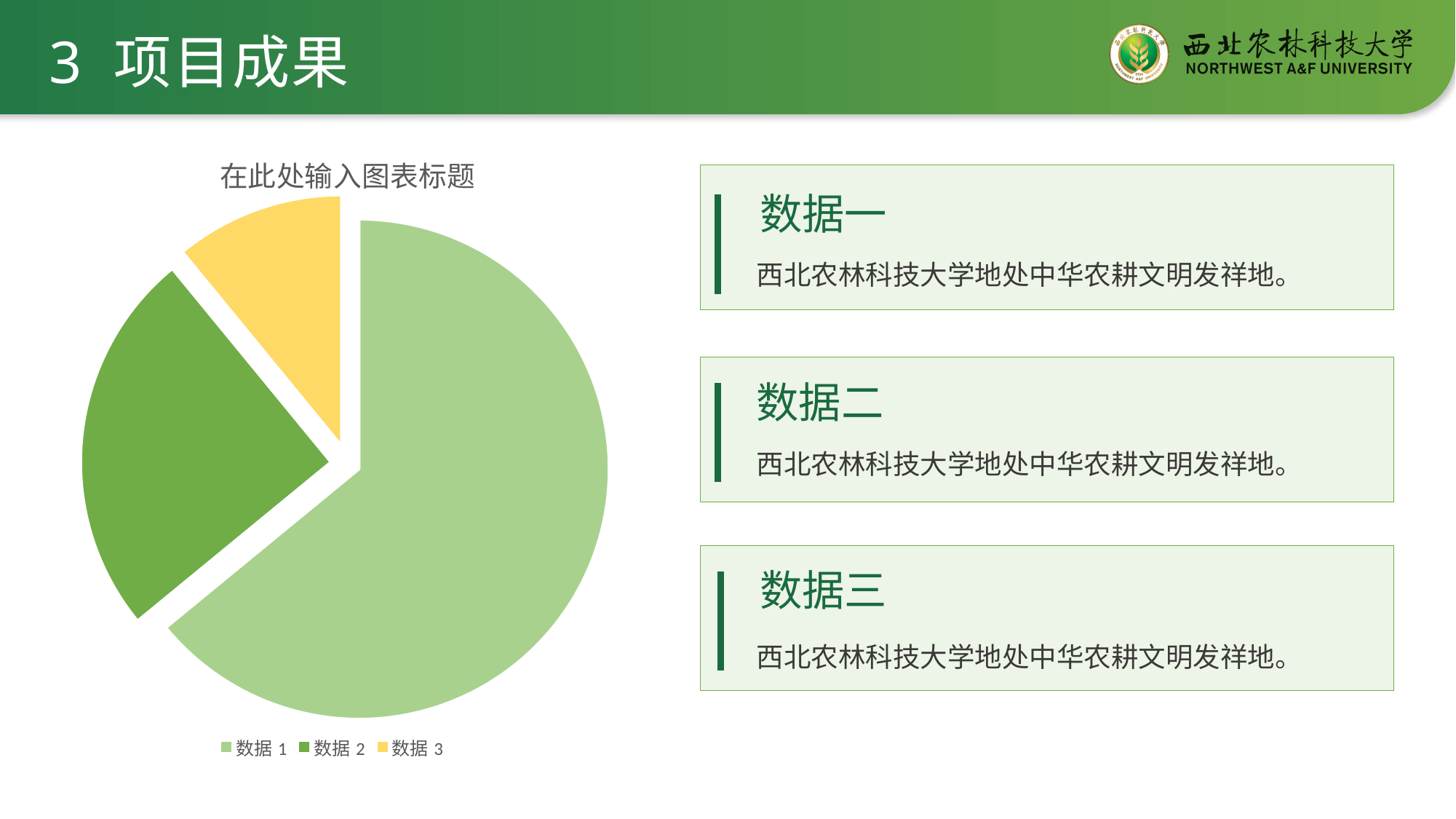
Which slice is larger in the pie chart, 数据 2 or 数据 3? 数据 2 What is the title of the pie chart? 在此处输入图表标题 Which slice is larger in the pie chart, 数据 1 or 数据 2? 数据 1 How many entries does the legend of the pie chart list? 3 Which category has the smallest slice in the pie chart? 数据 3 Does the slice for 数据 1 take up more or less than half of the pie chart? more How many slices does the pie chart have? 3 What colour is the slice for 数据 3 in the pie chart? yellow What kind of chart is shown on the slide? pie chart Which category has the largest slice in the pie chart? 数据 1